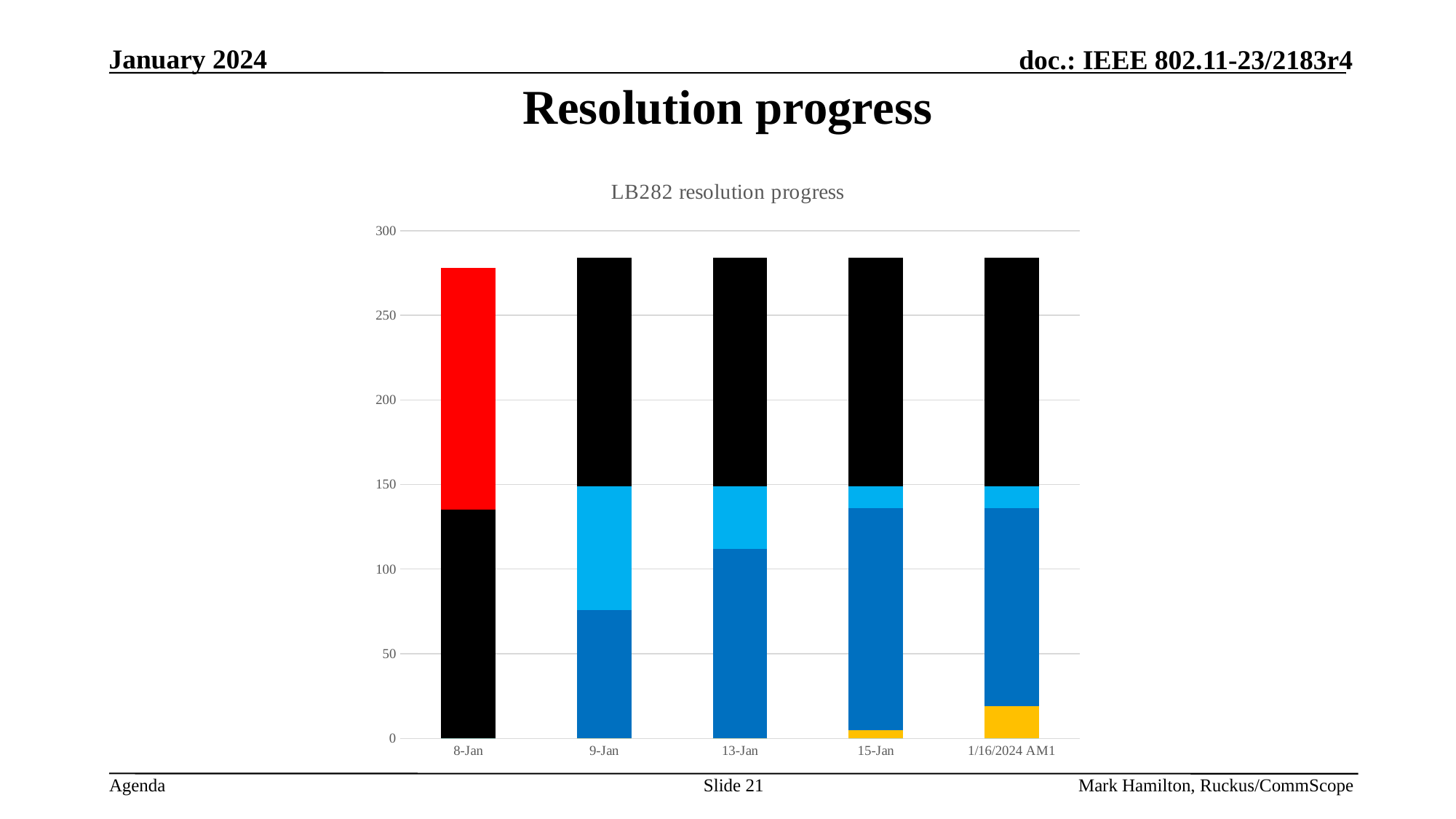
Is the total height of the 9-Jan bar greater or less than 250? greater Does the dark blue segment rise or fall from 9-Jan to 1/16/2024 AM1? rise Which has the larger dark blue segment, 9-Jan or 13-Jan? 13-Jan Is the black bottom segment of the 8-Jan bar greater or less than 100? greater What is the title of the chart? LB282 resolution progress Is the top of the dark blue segment in the 15-Jan bar greater or less than 100? greater What kind of chart is shown on the slide? stacked bar chart What is the label of the last category on the x axis? 1/16/2024 AM1 How many dates (categories) are shown on the x axis? 5 Which bar has the lowest total height? 8-Jan